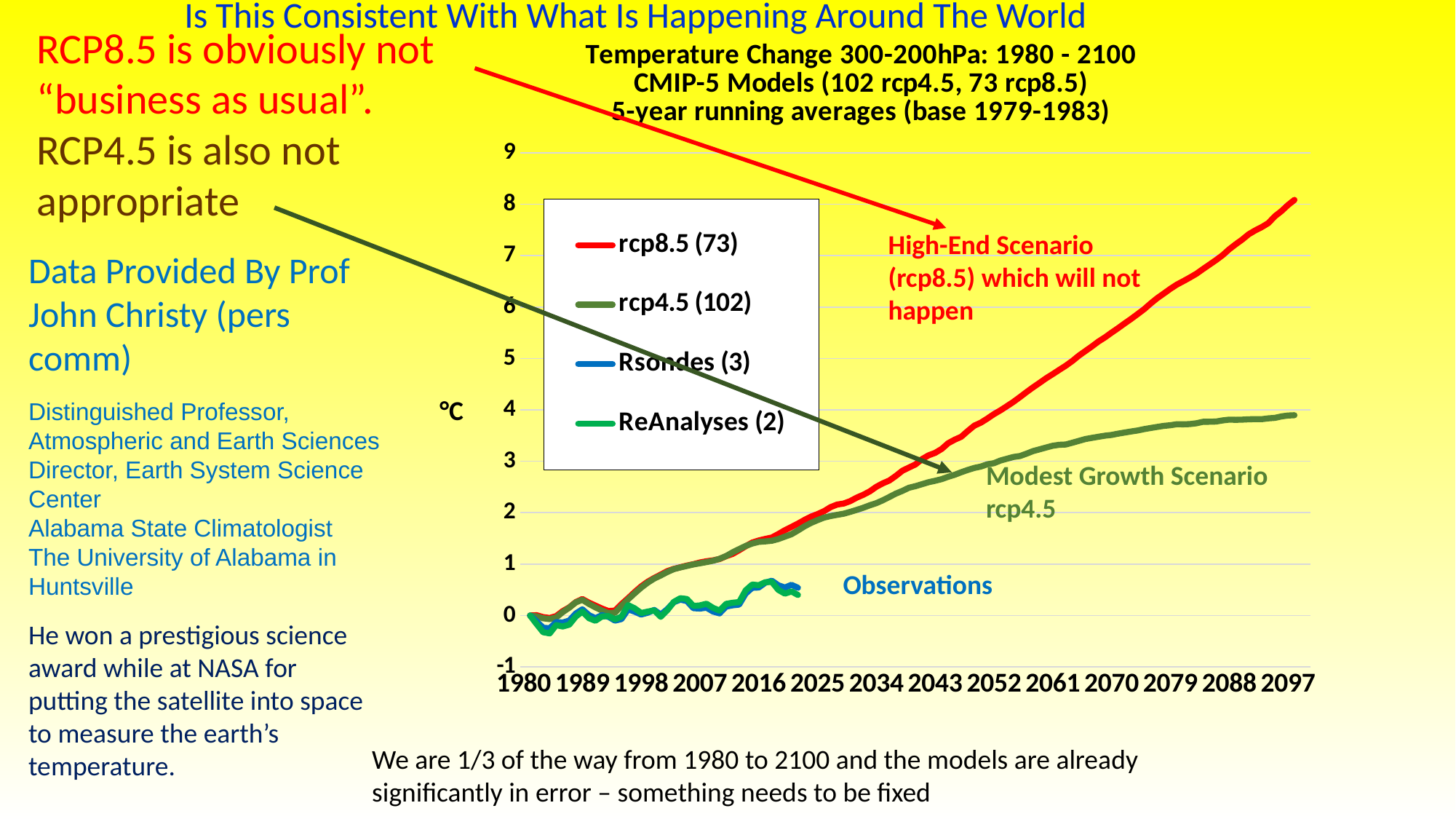
At 2097, which is larger: the rcp8.5 (73) value or the rcp4.5 (102) value? rcp8.5 (73) What kind of chart is shown on the slide? line chart What is the first line of the chart title? Temperature Change 300-200hPa: 1980 - 2100 Is the value for rcp4.5 (102) at 2097 greater or less than 3? greater How many series does the chart legend list? 4 Is the value for rcp8.5 (73) at 2097 greater or less than 7? greater Is the value for Rsondes (3) at 2016 greater or less than 1? less Which series reaches the highest value by 2097? rcp8.5 (73) Does the rcp8.5 (73) series rise or fall from 1980 to 2097? rise How many year labels are shown along the x axis? 14 What unit is shown as the y-axis label? °C